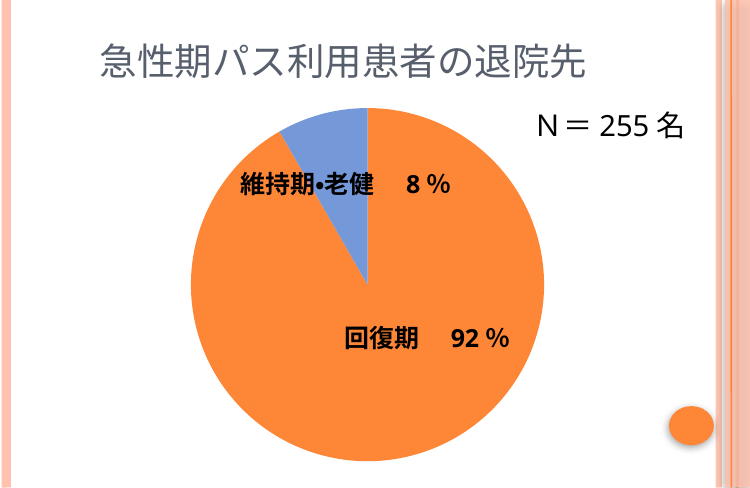
How many slices does the pie chart have? 2 Which is larger, the share for 回復期 or the share for 維持期・老健? 回復期 What percentage of the pie is 維持期・老健? 8% What kind of chart is shown on the slide? pie chart Which category has the largest share of the pie? 回復期 What share of the pie does 回復期 represent? 92% Which category has the smallest share of the pie? 維持期・老健 What is the title of the chart? 急性期パス利用患者の退院先 What percentage of the pie is 回復期? 92% What is the difference in percentage points between 回復期 and 維持期・老健? 84 What is the total number of patients (N) shown on the slide? 255名